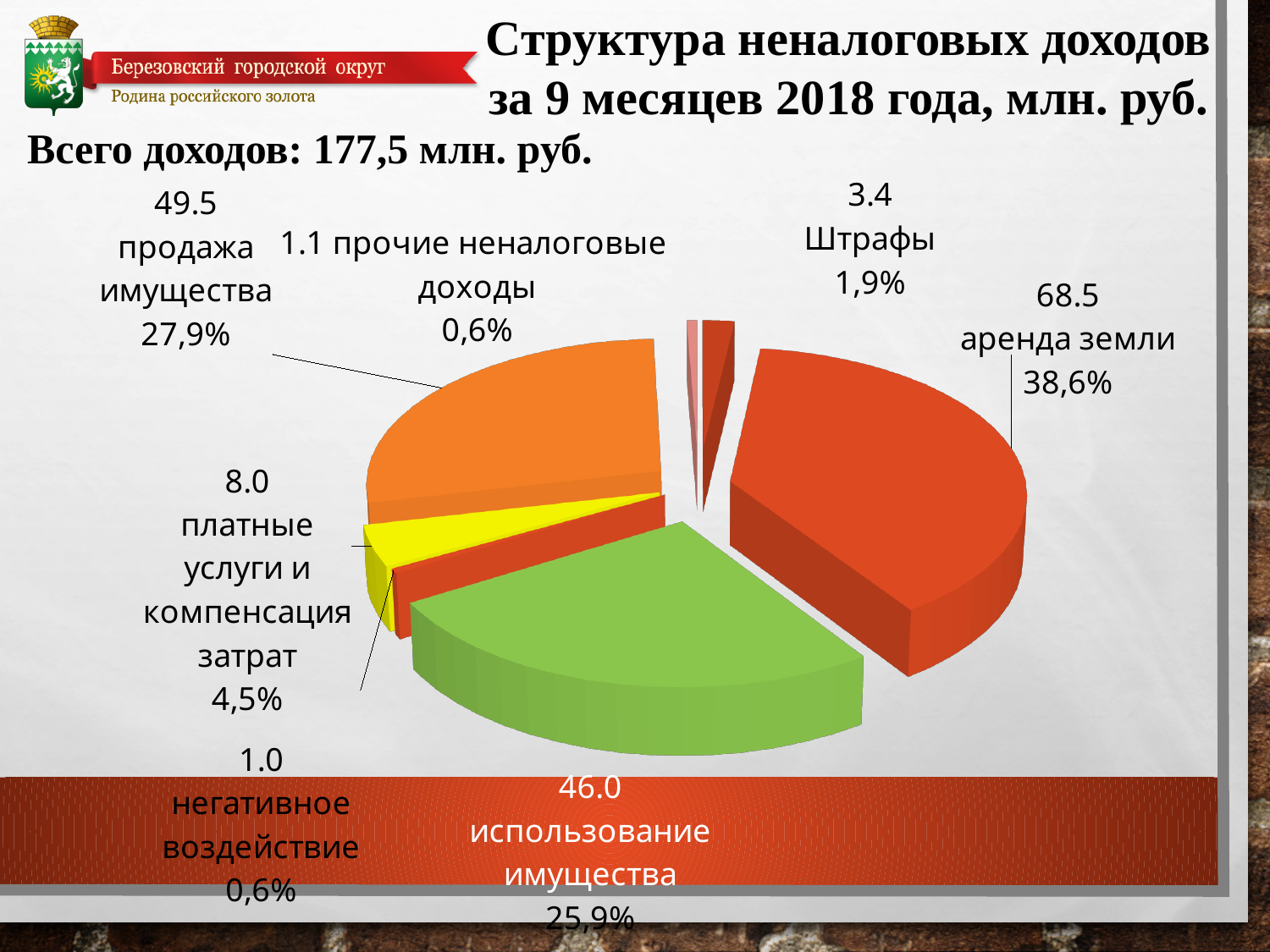
What share of the pie does использование имущества have? 25,9% What is the difference between the values for аренда земли and продажа имущества? 19.0 What is the value for платные услуги и компенсация затрат? 8.0 What total income is stated on the slide above the chart? 177,5 млн. руб. What kind of chart is shown on the slide? pie chart What is the value for продажа имущества? 49.5 What share of the pie does Штрафы have? 1,9% Which category has the largest slice of the pie? аренда земли What is the value for аренда земли? 68.5 What share of the pie does прочие неналоговые доходы have? 0,6% How many slices does the pie chart have? 7 Which is larger, the value for использование имущества or the value for продажа имущества? продажа имущества